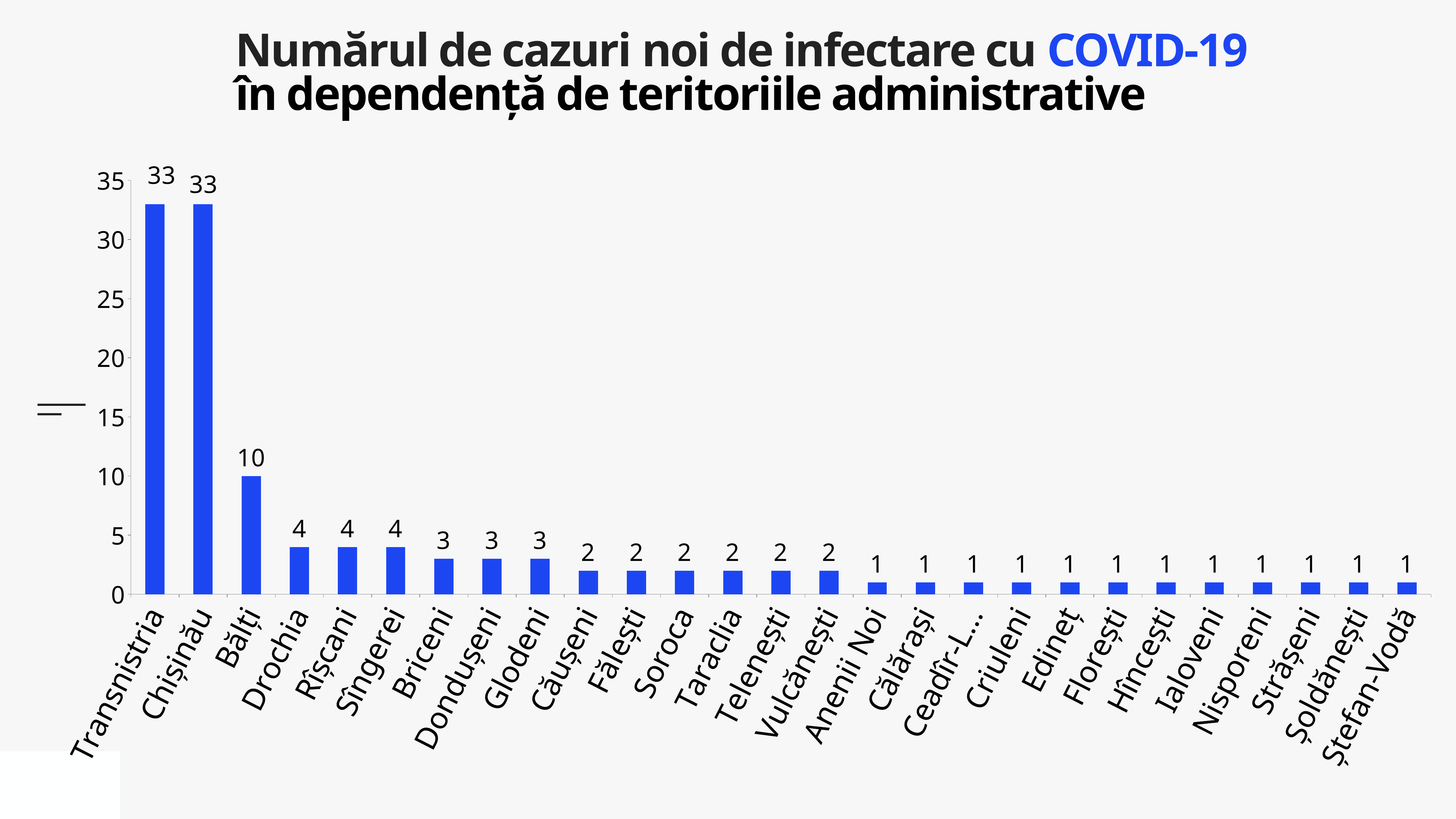
What is the value for Ialoveni? 1 What is the difference between the values for Chișinău and Bălți? 23 What is the value for Transnistria? 33 What is the value for Soroca? 2 What is the value for Drochia? 4 Is the value for Bălți greater or less than 15? less What is the value for Briceni? 3 What kind of chart is shown on the slide? bar chart Which is larger, the value for Glodeni or the value for Căușeni? Glodeni What is the difference between the values for Bălți and Sîngerei? 6 What is the value for Bălți? 10 How many categories are shown on the x axis? 27